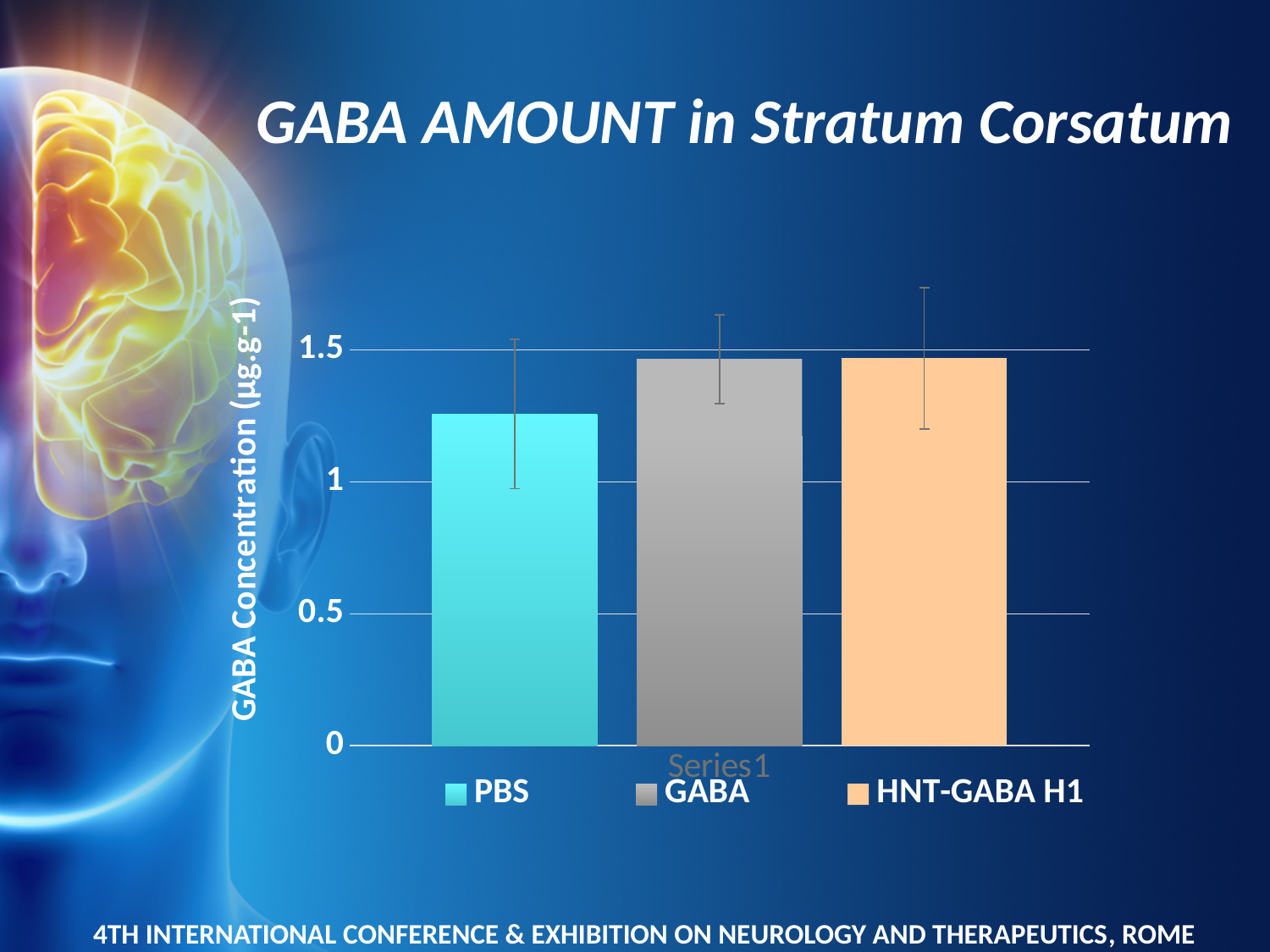
Is the value for HNT-GABA H1 greater or less than 1? greater Which series has the lowest GABA concentration? PBS Is the value for PBS greater or less than 1? greater What is the label of the vertical axis? GABA Concentration (µg.g-1) Is the value for GABA greater or less than 1.5? less Which is larger, the value for PBS or the value for GABA? GABA What is the title of the chart? GABA AMOUNT in Stratum Corsatum How many series does the legend list? 3 What kind of chart is shown on the slide? bar chart Which is larger, the value for HNT-GABA H1 or the value for PBS? HNT-GABA H1 How many bars are plotted in the chart? 3